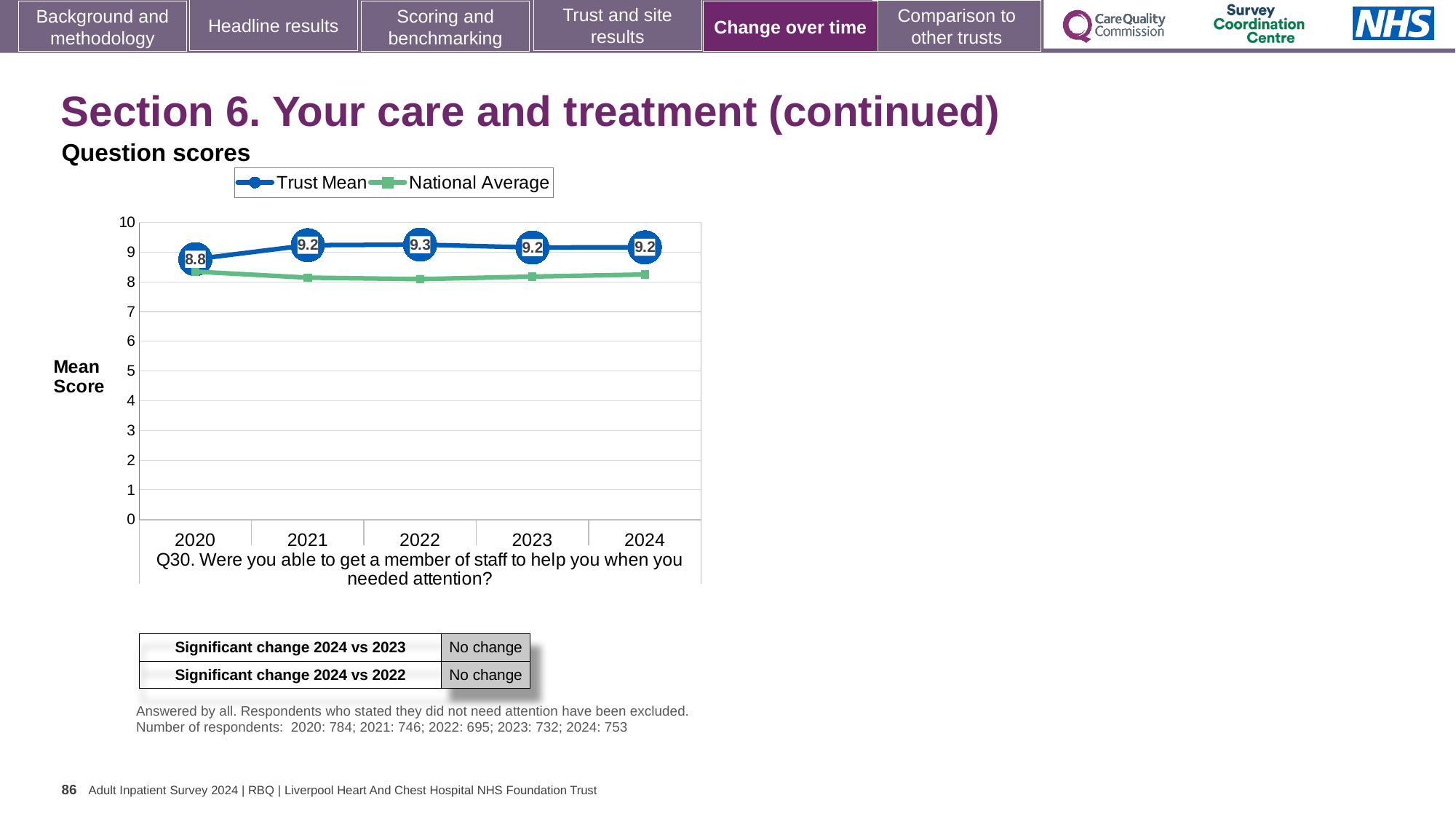
What kind of chart is shown? line chart How many series does the legend list? 2 How many years are plotted on the x axis? 5 What is the difference between the Trust Mean score in 2022 and in 2020? 0.5 In which year is the Trust Mean score lowest? 2020 In which year is the Trust Mean score highest? 2022 Is the Trust Mean value for 2021 greater or less than 9? greater What is the Trust Mean score for 2022? 9.3 What is the Trust Mean score for 2024? 9.2 Which is larger in 2024, the Trust Mean or the National Average? Trust Mean What is the Trust Mean score for 2020? 8.8 Is the National Average value for 2022 greater or less than 9? less